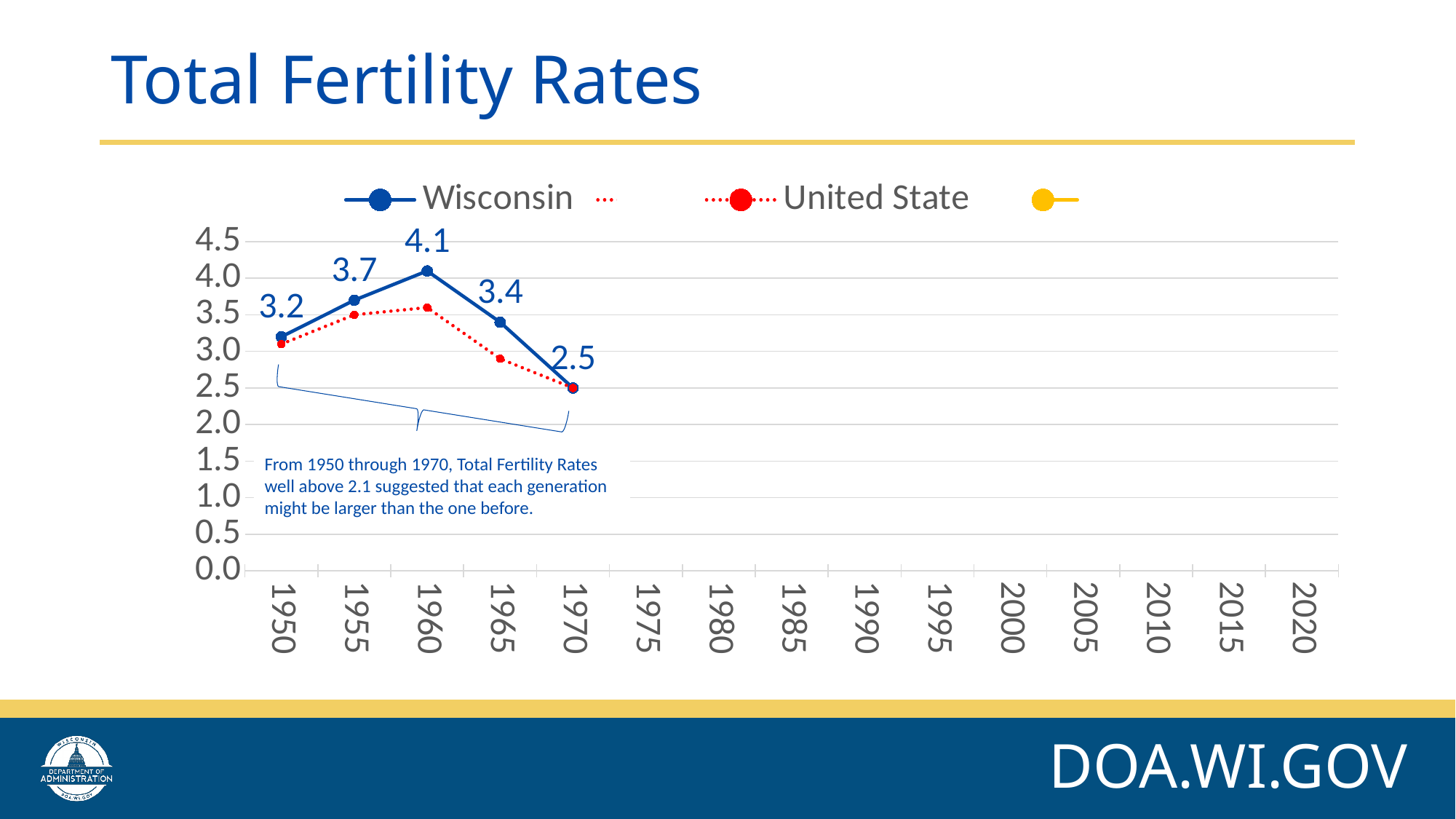
What is the Wisconsin total fertility rate in 1960? 4.1 What kind of chart is shown on the slide? line chart Is the United States total fertility rate in 1960 greater or less than 3.0? greater What is the Wisconsin total fertility rate in 1970? 2.5 In which year is the Wisconsin total fertility rate highest? 1960 What is the difference between the Wisconsin total fertility rate in 1960 and in 1970? 1.6 How many data points are plotted for the Wisconsin series? 5 What is the Wisconsin total fertility rate in 1950? 3.2 Is the United States total fertility rate in 1965 greater or less than 3.0? less In which year is the Wisconsin total fertility rate lowest? 1970 Does the Wisconsin total fertility rate rise or fall from 1960 to 1970? fall Which is larger, the Wisconsin total fertility rate in 1955 or in 1965? 1955